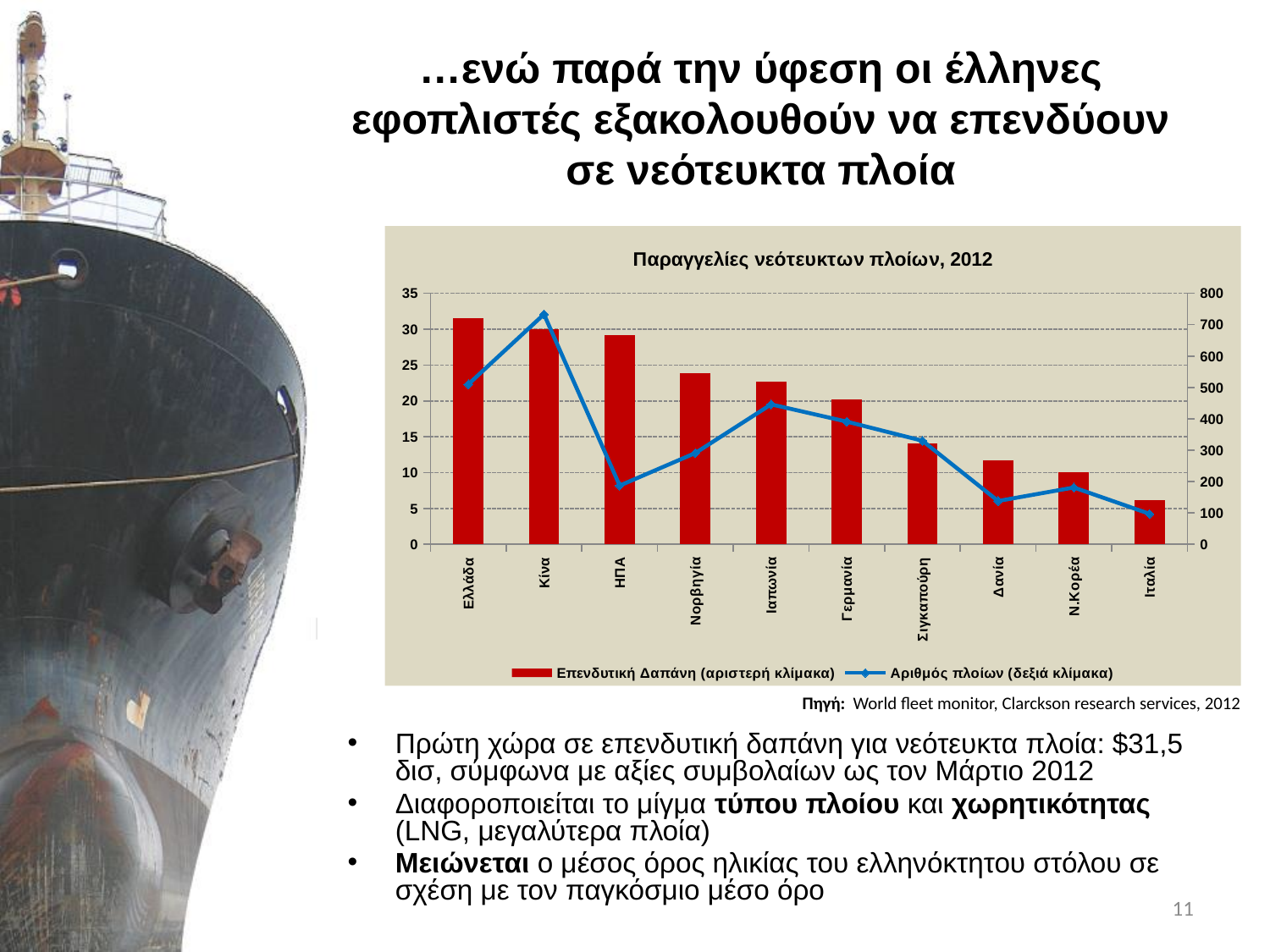
How many series does the chart legend list? 2 Which country has the highest bar for Επενδυτική Δαπάνη? Ελλάδα How many countries are shown on the x axis of the chart? 10 Which country has the highest value on the Αριθμός πλοίων line? Κίνα Is the Αριθμός πλοίων value for ΗΠΑ greater or less than 300? less What is the title of the chart? Παραγγελίες νεότευκτων πλοίων, 2012 Is the Επενδυτική Δαπάνη bar for Νορβηγία greater or less than 20? greater Which country has the lowest bar for Επενδυτική Δαπάνη? Ιταλία What kind of chart is shown on the slide? A combined bar and line chart Which has the larger Επενδυτική Δαπάνη bar, Γερμανία or Σιγκαπούρη? Γερμανία Do the Επενδυτική Δαπάνη bars generally rise or fall from left to right across the x axis? fall Which series is plotted on the right-hand scale according to the legend? Αριθμός πλοίων